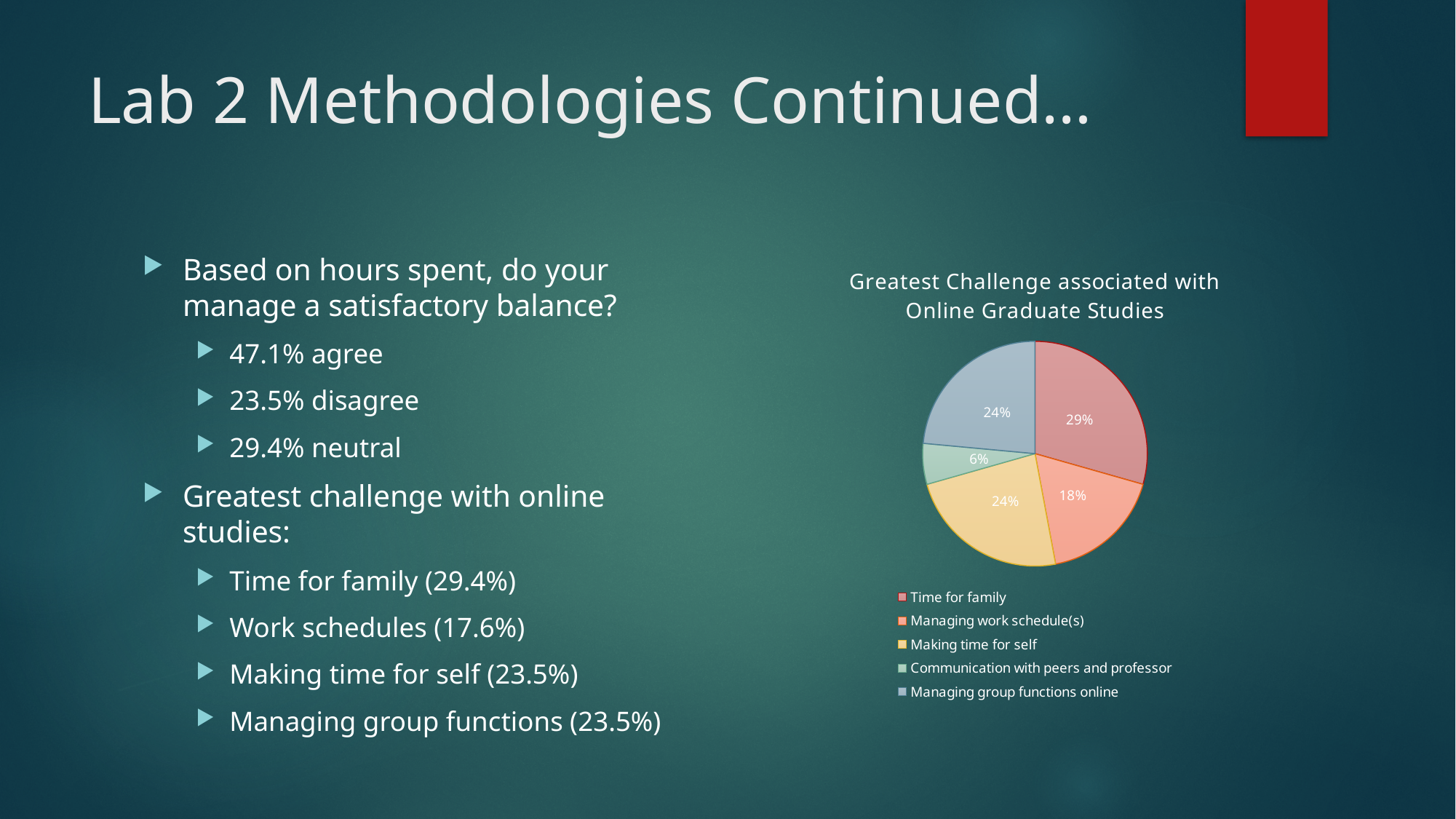
What percentage of the pie chart is labelled for Time for family? 29% Which slice is larger: Time for family or Managing work schedule(s)? Time for family What percentage is shown for Making time for self? 24% What type of chart is shown on the slide? Pie chart Which category has the largest slice of the pie chart? Time for family What is the title of the chart? Greatest Challenge associated with Online Graduate Studies How many entries does the chart legend list? 5 How many slices does the pie chart have? 5 Which category has the smallest slice of the pie chart? Communication with peers and professor What percentage is shown for Communication with peers and professor? 6% What percentage does the Managing work schedule(s) slice show? 18% What is the difference between the Time for family slice and the Managing work schedule(s) slice? 11%